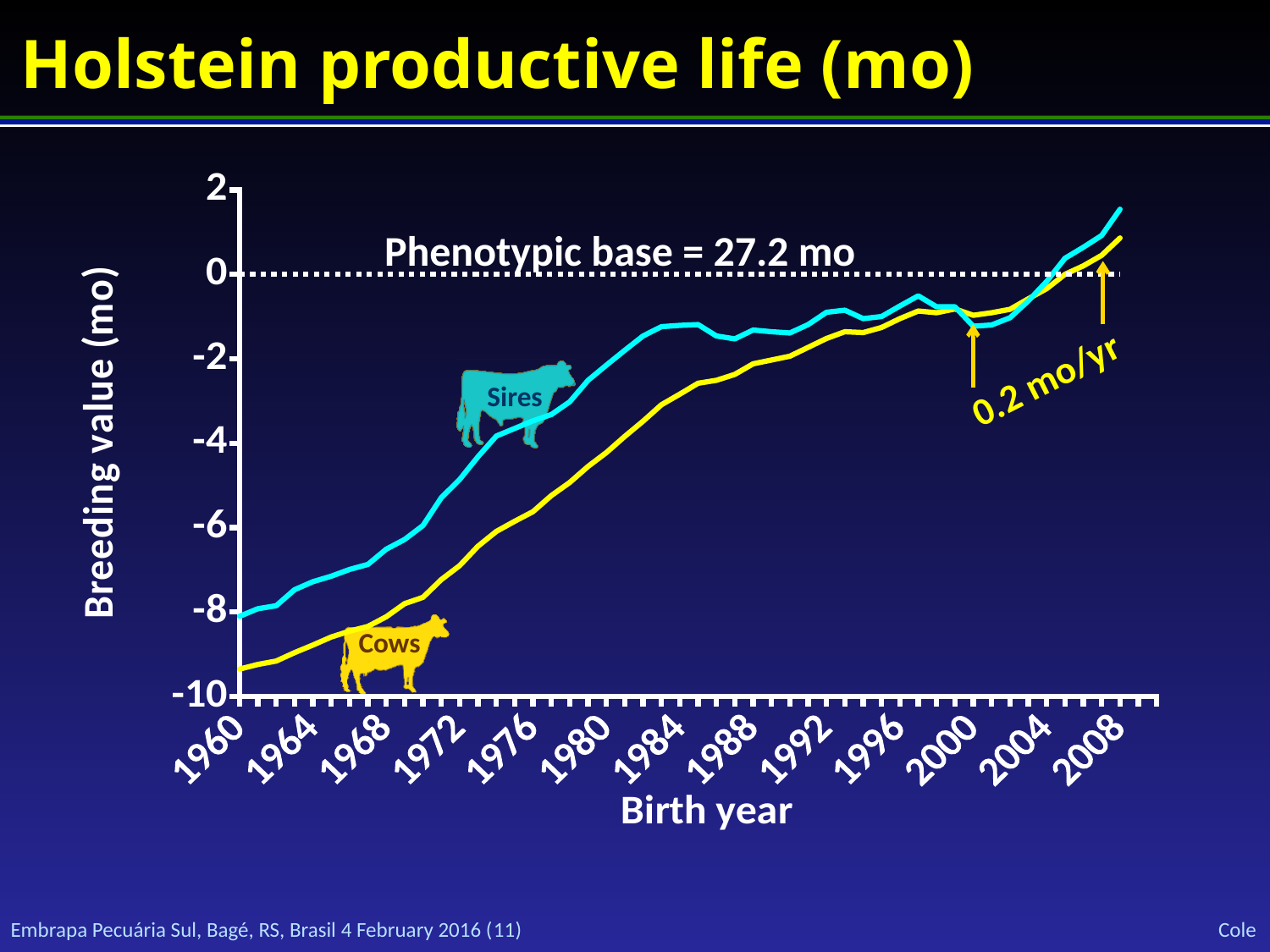
Do the breeding values for Cows rise or fall as birth year increases? rise Do the breeding values for Sires rise or fall as birth year increases? rise Is the breeding value for Sires in 1968 greater or less than -6? less What are the two series plotted on the chart? Sires and Cows What is the phenotypic base value stated on the chart? 27.2 mo What kind of chart is shown on the slide? line chart Is the breeding value for Sires in 2008 greater or less than 0? greater How many series are plotted on the chart? 2 Is the breeding value for Cows in 1960 greater or less than -8? less What rate of change is annotated near the right end of the chart? 0.2 mo/yr For birth year 1976, which series has the higher breeding value, Sires or Cows? Sires